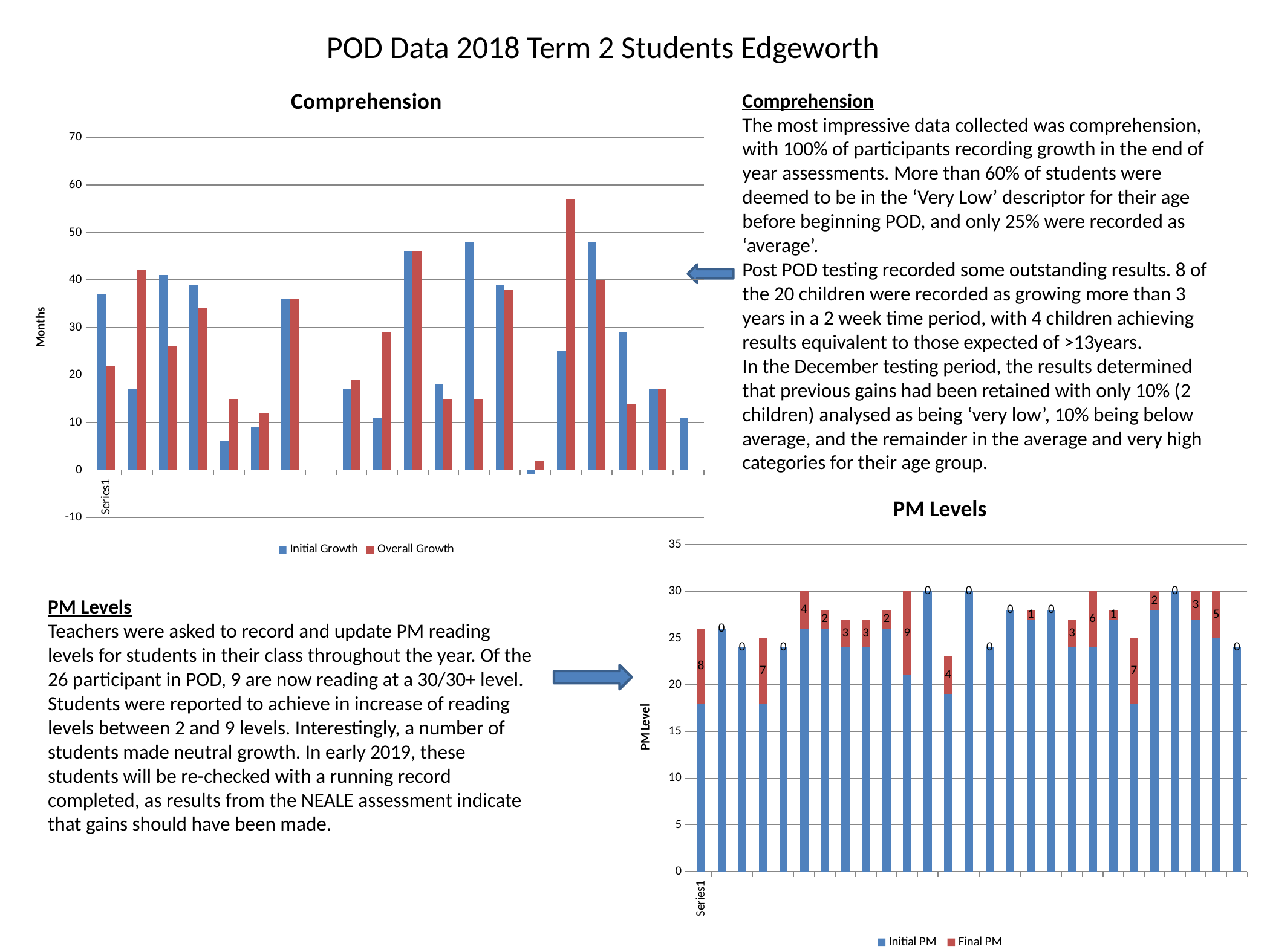
On the Comprehension chart, is the tallest Overall Growth bar greater or less than 50? greater How many series does the legend of the Comprehension chart list? 2 What is the title of the vertical axis on the PM Levels chart? PM Level On the PM Levels chart, what is the largest Final PM value shown as a data label? 9 How many bars (students) are plotted on the PM Levels chart? 27 What are the two series named in the legend of the Comprehension chart? Initial Growth and Overall Growth On the Comprehension chart, is the tallest Initial Growth bar greater or less than 50? less How many series does the legend of the PM Levels chart list? 2 What kind of chart is the Comprehension chart? bar chart On the PM Levels chart, is the tallest stacked bar greater or less than 25? greater What kind of chart is the PM Levels chart? stacked bar chart